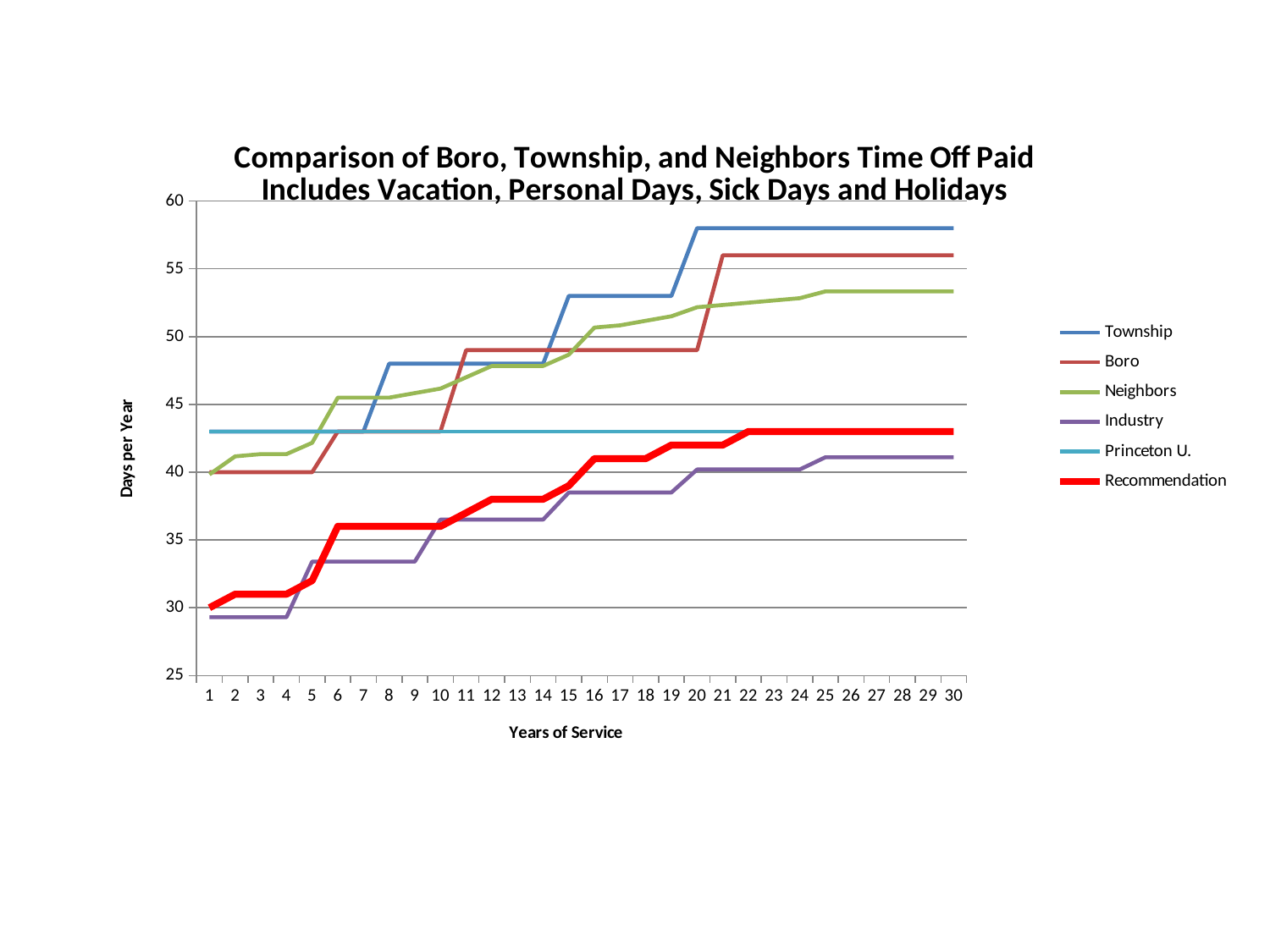
Is the Industry value at year 1 greater or less than 30? less How many years of service are shown along the x axis? 30 Which series is drawn as a thick red line? Recommendation Which series has the lowest value at year 30 of service? Industry At year 30, which is larger, Boro or Neighbors? Boro Is the Township value at year 30 greater or less than 55? greater What kind of chart is shown on the slide? line chart What is the Recommendation value at year 1 of service? 30 Which series has the highest value at year 30 of service? Township Does the Township line rise or fall as years of service increase? rise How many series does the legend list? 6